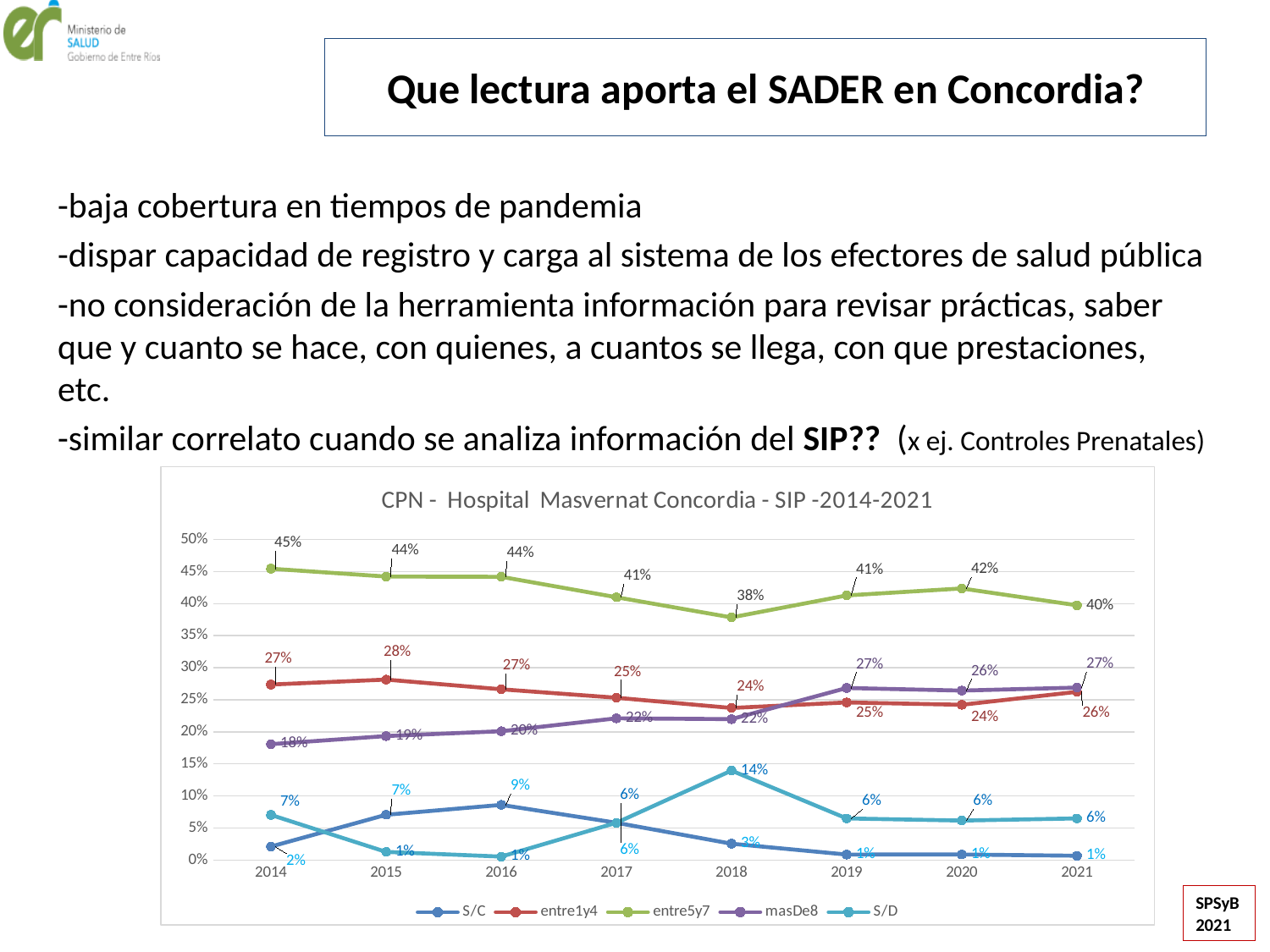
What is the difference between the entre5y7 value in 2014 and its value in 2018? 7% In which year does the entre5y7 series reach its lowest value? 2018 Is the value of the entre5y7 series in 2020 greater or less than 35%? greater Which series has the higher value in 2019, entre1y4 or masDe8? masDe8 What is the value of the S/D series in 2018? 14% In which year does the S/C series reach its highest value? 2016 What is the value of the entre5y7 series in 2014? 45% What is the value of the masDe8 series in 2021? 27% How many years are plotted along the x axis of the chart? 8 What is the title of the chart? CPN - Hospital Masvernat Concordia - SIP -2014-2021 How many series does the chart legend list? 5 What type of chart is shown on the slide? line chart